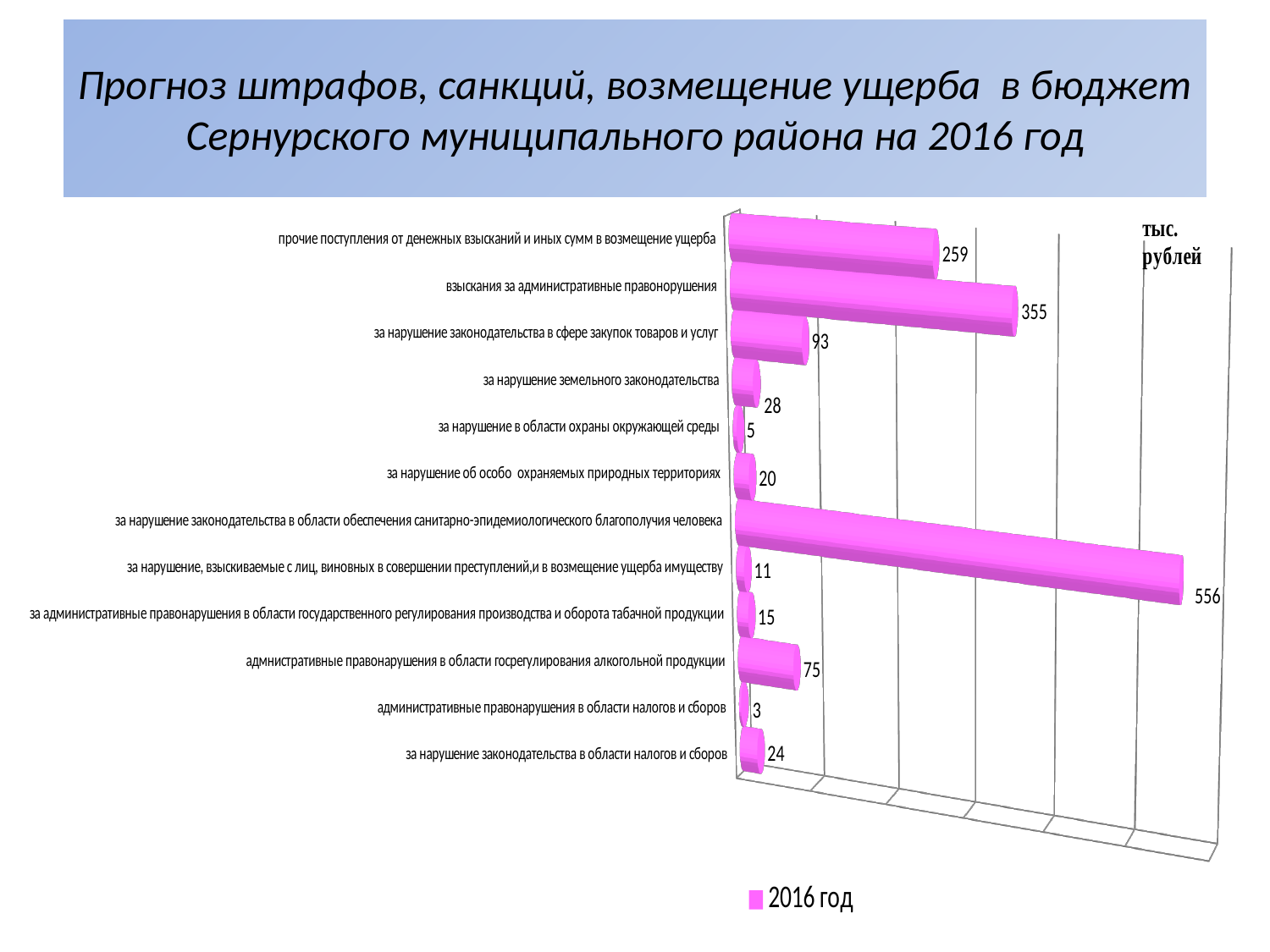
What is the value for "адмнистративные правонарушения в области госрегулирования алкогольной продукции"? 75 What kind of chart is shown on the slide? bar chart Which category has the lowest value? административные правонарушения в области налогов и сборов How many series does the legend list? 1 What series name is shown in the legend? 2016 год What is the value for "прочие поступления от денежных взысканий и иных сумм в возмещение ущерба"? 259 What is the value for "за нарушение законодательства в сфере закупок товаров и услуг"? 93 How many categories are shown in the chart? 12 What is the difference between the values for "взыскания за административные правонарушения" and "прочие поступления от денежных взысканий и иных сумм в возмещение ущерба"? 96 What is the value for "взыскания за административные правонарушения"? 355 Which is larger: the value for "за нарушение земельного законодательства" or the value for "за нарушение законодательства в области налогов и сборов"? за нарушение земельного законодательства Which category has the highest value? за нарушение законодательства в области обеспечения санитарно-эпидемиологического благополучия человека